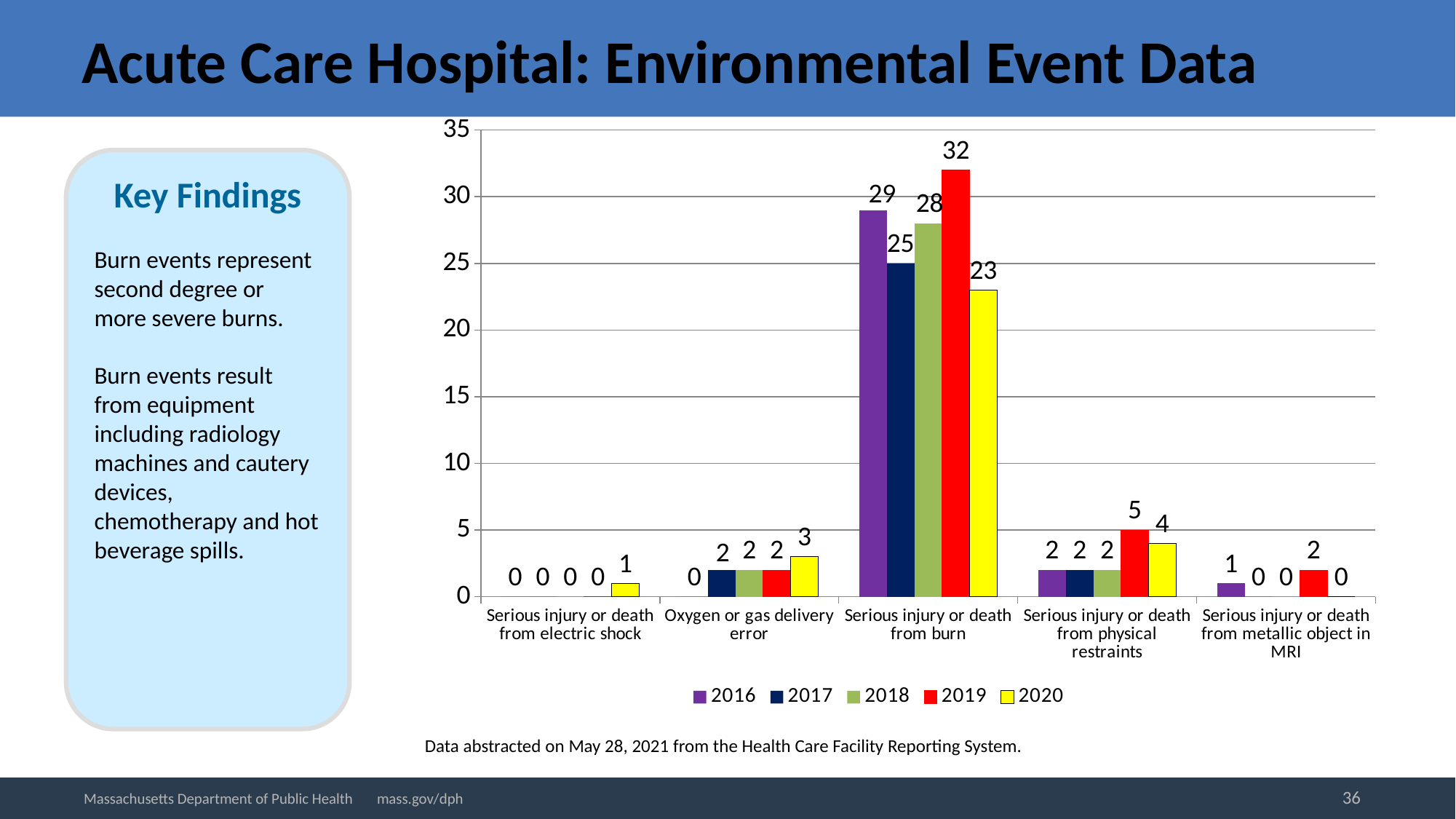
What is the value for 2020 in the 'Oxygen or gas delivery error' category? 3 What is the value for 2017 in the 'Serious injury or death from burn' category? 25 How many series does the legend list? 5 What kind of chart is shown on the slide? Bar chart What is the value for 2019 in the 'Serious injury or death from burn' category? 32 What is the difference between the 2019 and 2020 values in the 'Serious injury or death from burn' category? 9 Which is larger in the 'Serious injury or death from burn' category: the 2016 value or the 2018 value? 2016 Which colour represents the 2019 series in the legend? Red How many event categories are shown on the x axis? 5 Which year has the lowest value in the 'Serious injury or death from burn' category? 2020 What is the value for 2019 in the 'Serious injury or death from physical restraints' category? 5 Which year has the highest value in the 'Serious injury or death from burn' category? 2019